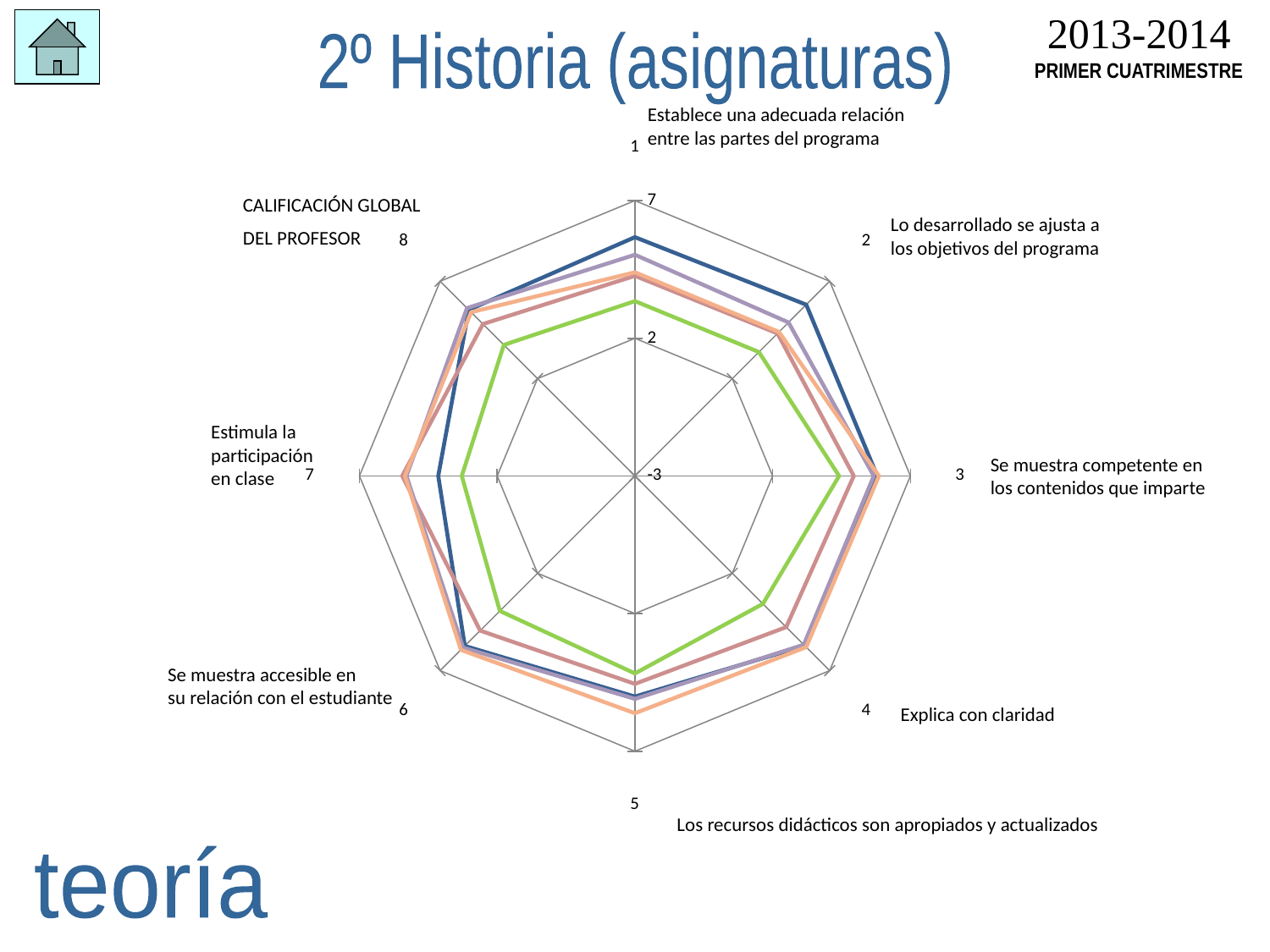
Which category label is numbered 5 on the radar chart? Los recursos didácticos son apropiados y actualizados Is the dark blue line's value for 'Establece una adecuada relación entre las partes del programa' greater or less than 7? less Is the green line's value for 'Se muestra competente en los contenidos que imparte' greater or less than 2? greater For 'Estimula la participación en clase', which line has the higher value, the dark blue line or the green line? the dark blue line How many categories (axes) does the radar chart have? 8 For the dark blue line, which category has the lowest value? Estimula la participación en clase Is the green line's value for 'Explica con claridad' greater or less than 7? less What is the title of the slide containing the radar chart? 2º Historia (asignaturas) What kind of chart is shown on the slide? radar chart How many lines (series) are plotted on the radar chart? 5 For 'Establece una adecuada relación entre las partes del programa', which line has the higher value, the dark blue line or the green line? the dark blue line